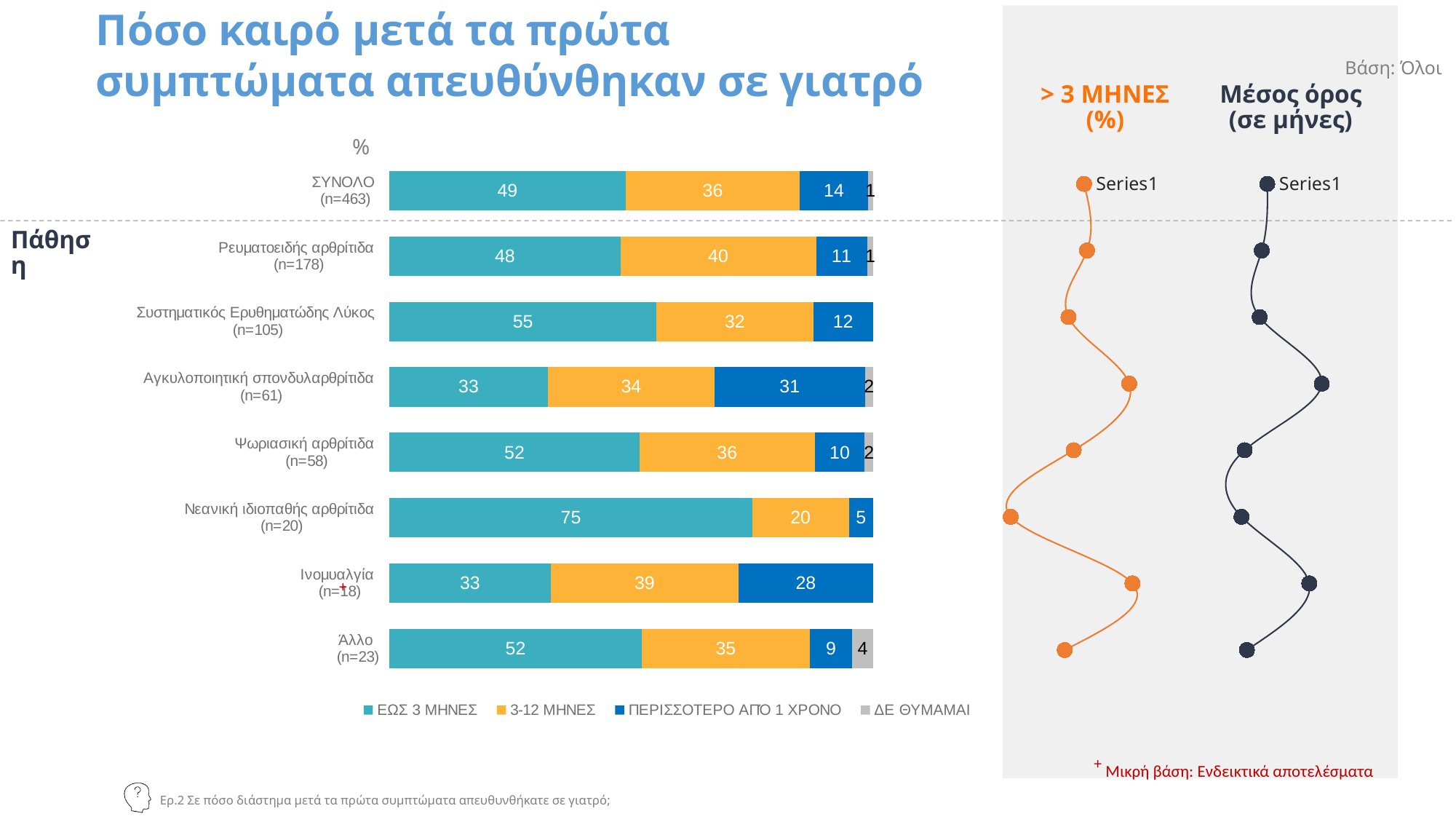
In the stacked bar chart, what is the difference between the ΕΩΣ 3 ΜΗΝΕΣ and 3-12 ΜΗΝΕΣ values for ΣΥΝΟΛΟ (n=463)? 13 In the stacked bar chart, which category has the highest ΠΕΡΙΣΣΟΤΕΡΟ ΑΠΟ 1 ΧΡΟΝΟ value? Αγκυλοποιητική σπονδυλαρθρίτιδα (n=61) In the stacked bar chart, what percentage of ΣΥΝΟΛΟ (n=463) answered ΕΩΣ 3 ΜΗΝΕΣ? 49 How many series does the legend of the stacked bar chart list? 4 How many categories (rows) does the stacked bar chart show? 8 In the stacked bar chart, what is the 3-12 ΜΗΝΕΣ value for Ρευματοειδής αρθρίτιδα (n=178)? 40 In the stacked bar chart, which category has the lowest 3-12 ΜΗΝΕΣ value? Νεανική ιδιοπαθής αρθρίτιδα (n=20) What kind of chart is the main chart on the left of the slide? Stacked bar chart In the stacked bar chart, which category has the highest ΕΩΣ 3 ΜΗΝΕΣ value? Νεανική ιδιοπαθής αρθρίτιδα (n=20) In the stacked bar chart, what is the ΠΕΡΙΣΣΟΤΕΡΟ ΑΠΟ 1 ΧΡΟΝΟ value for Ινομυαλγία (n=18)? 28 In the stacked bar chart, what is the ΔΕ ΘΥΜΑΜΑΙ value for Άλλο (n=23)? 4 In the stacked bar chart, which is larger: the ΕΩΣ 3 ΜΗΝΕΣ value for Συστηματικός Ερυθηματώδης Λύκος (n=105) or for Ψωριασική αρθρίτιδα (n=58)? Συστηματικός Ερυθηματώδης Λύκος (n=105)